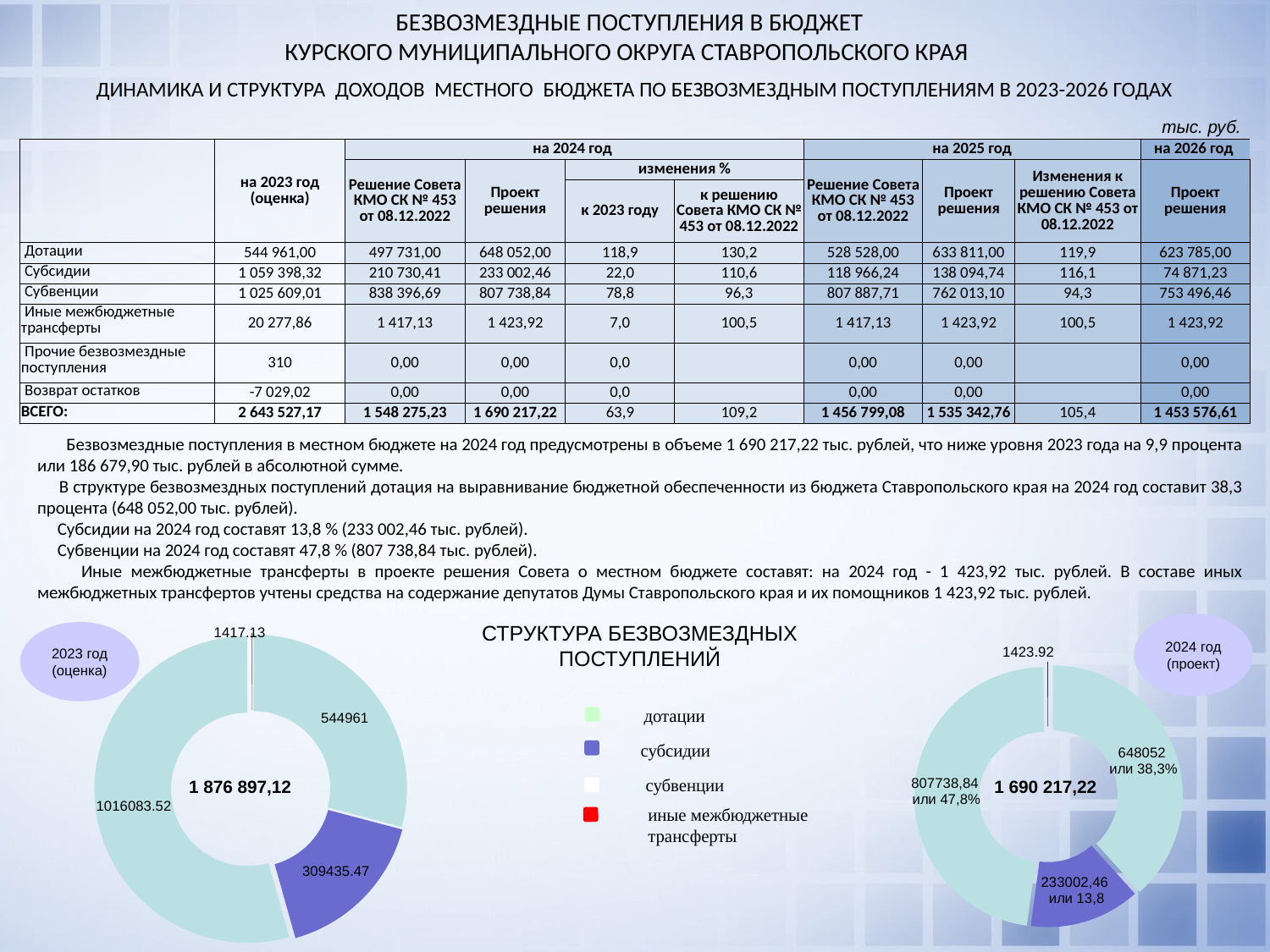
In the right doughnut chart (2024 год (проект)), what share of the total does the slice labelled 648052 represent? 38,3% How many slices does the right doughnut chart (2024 год (проект)) have? 4 In the right doughnut chart (2024 год (проект)), what total value is printed in the centre? 1 690 217,22 In the left doughnut chart (2023 год (оценка)), which slice is larger: the one labelled 544961 or the one labelled 309435.47? 544961 In the left doughnut chart (2023 год (оценка)), what is the value of the smallest slice? 1417.13 What is the title printed between the two doughnut charts? СТРУКТУРА БЕЗВОЗМЕЗДНЫХ ПОСТУПЛЕНИЙ In the right doughnut chart (2024 год (проект)), what share of the total does the slice labelled 807738,84 represent? 47,8% In the left doughnut chart (2023 год (оценка)), what is the value of the largest slice? 1016083.52 In the right doughnut chart (2024 год (проект)), what share of the total does the slice labelled 233002,46 represent? 13,8 How many entries does the shared legend between the two doughnut charts list? 4 In the left doughnut chart (2023 год (оценка)), what total value is printed in the centre? 1 876 897,12 What kind of chart is the chart labelled "2024 год (проект)" on the right of the slide? doughnut (pie) chart